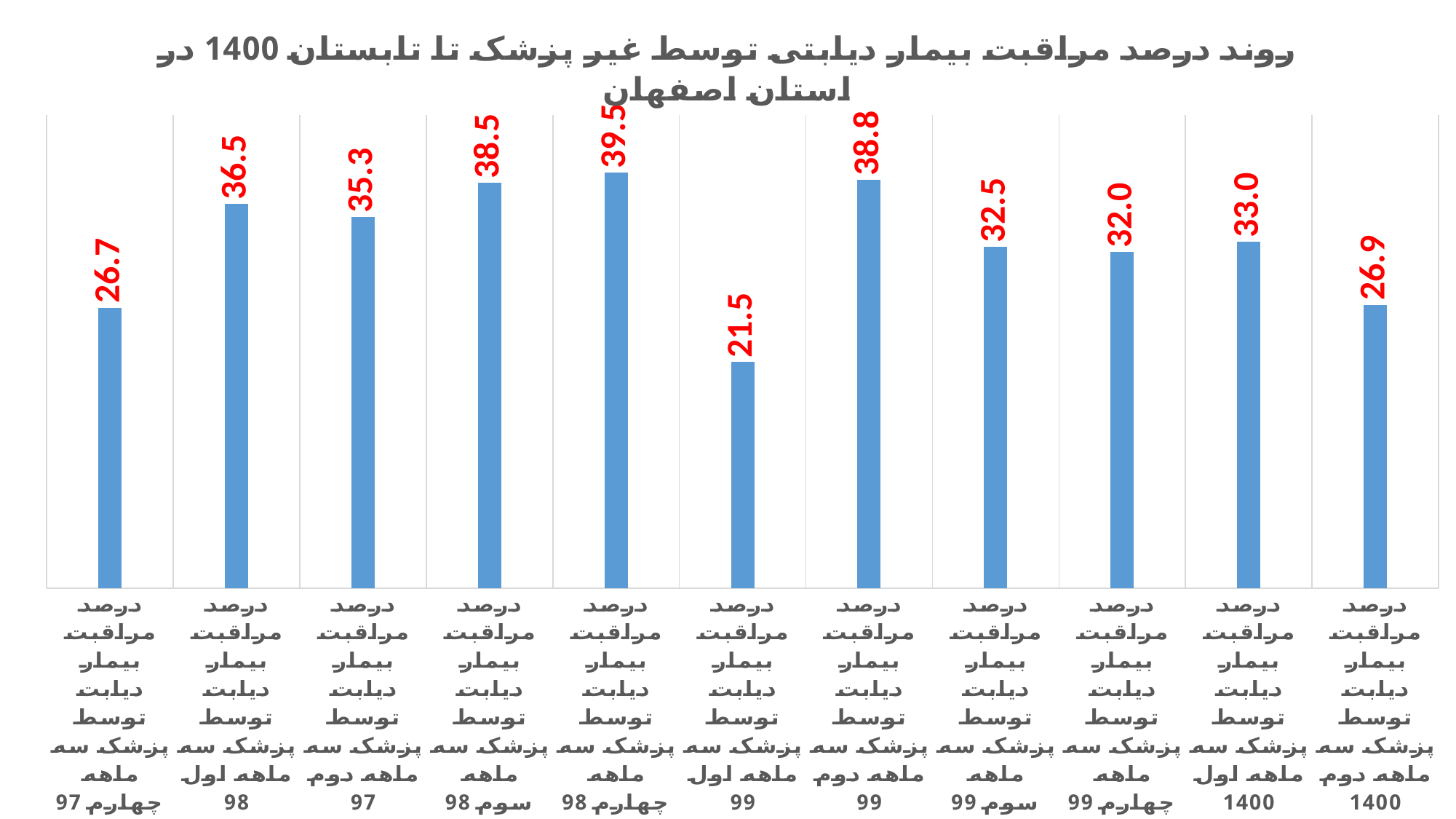
Which is larger: the value for سه ماهه دوم 99 or the value for سه ماهه سوم 99? سه ماهه دوم 99 What is the value of the bar for سه ماهه اول 99 (first quarter of 99)? 21.5 What is the value of the bar for سه ماهه دوم 1400 (second quarter of 1400)? 26.9 What type of chart is shown on the slide? bar chart What is the difference between the values for سه ماهه اول 1400 (33.0) and سه ماهه دوم 1400 (26.9)? 6.1 Which category has the lowest value in the chart? سه ماهه اول 99 What is the value of the bar for سه ماهه اول 98 (first quarter of 98)? 36.5 How many bars (categories) are plotted in the chart? 11 What is the difference between the values for سه ماهه چهارم 98 (39.5) and سه ماهه اول 99 (21.5)? 18.0 Which category has the highest value in the chart? سه ماهه چهارم 98 What is the value of the bar for سه ماهه چهارم 98 (fourth quarter of 98)? 39.5 What colour are the bars in the chart? blue